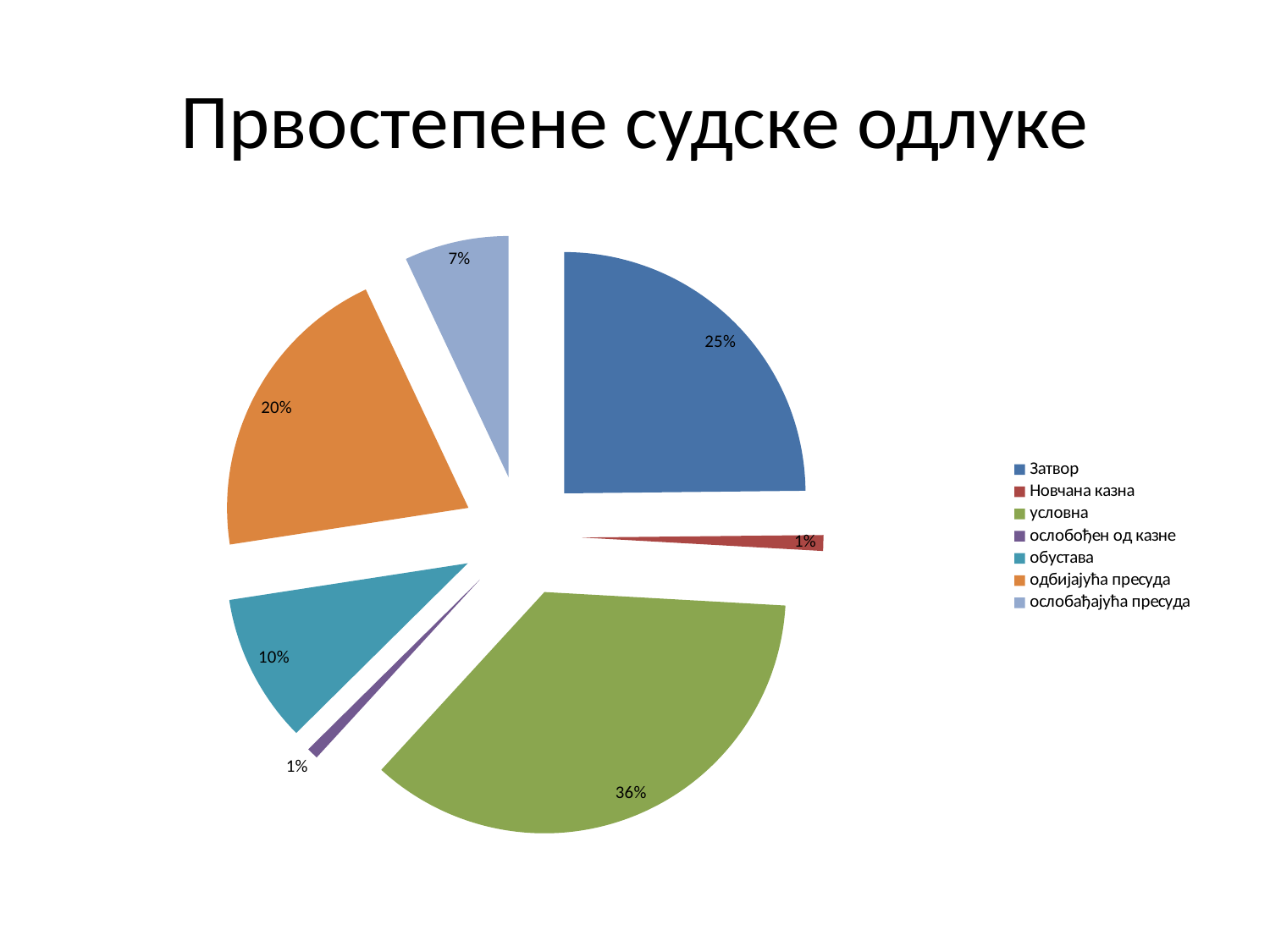
Which is larger, the share for одбијајућа пресуда or the share for обустава? одбијајућа пресуда How many categories does the legend list? 7 Which category has the largest slice of the pie? условна What kind of chart is shown on the slide? pie chart What share of the pie is ослобађајућа пресуда? 7% What is the difference between the shares of условна and Затвор? 11% What share of the pie is Затвор? 25% What colour is the slice for Затвор? blue What share of the pie is одбијајућа пресуда? 20% What is the title of the chart? Првостепене судске одлуке